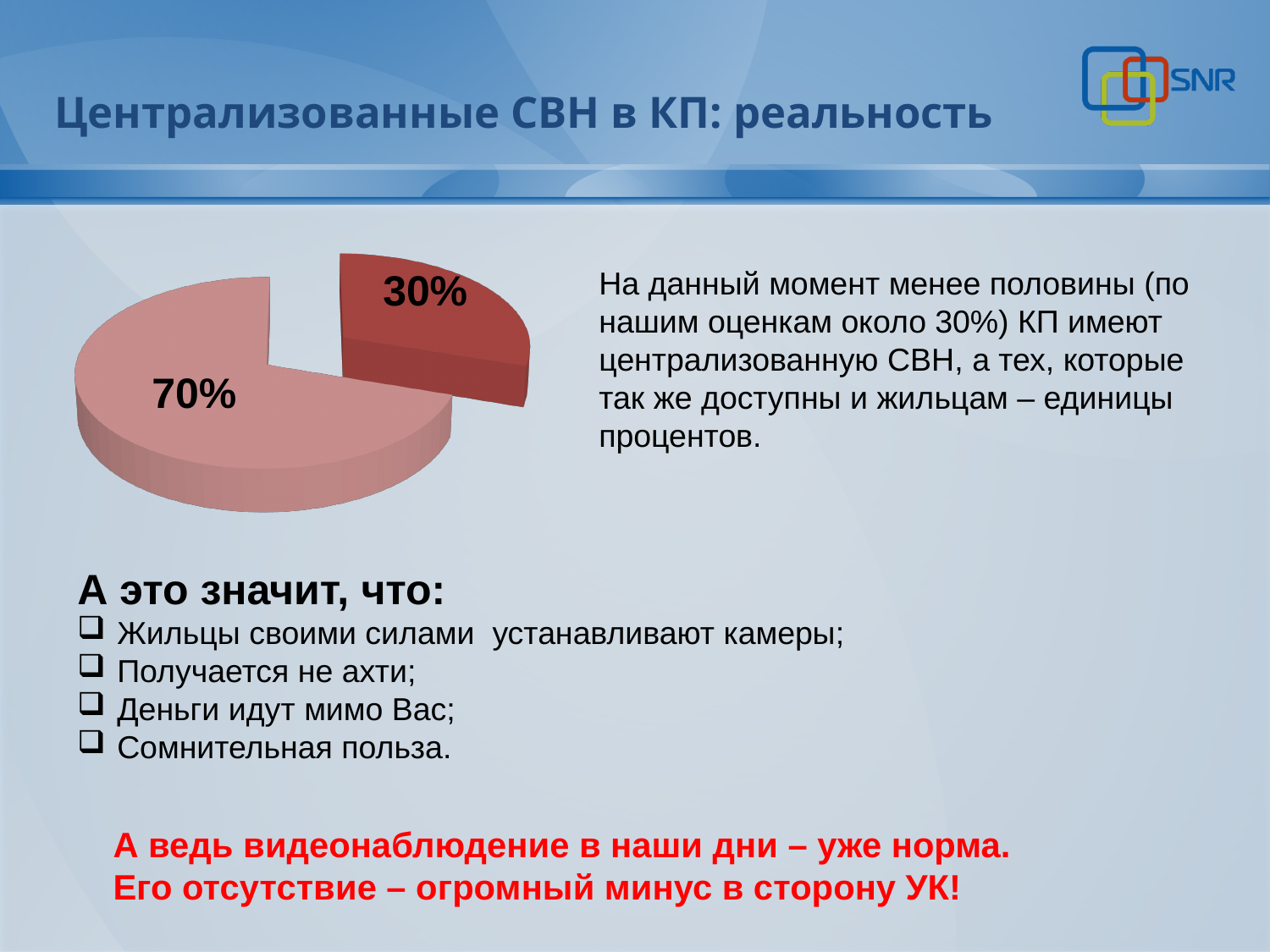
What is the value shown on the larger slice of the pie chart? 70% What is the smallest value shown on the pie chart? 30% What is the difference between the two slice values on the pie chart? 40% What share of the pie does the light pink slice represent? 70% What is the value shown on the smaller, dark red slice of the pie chart? 30% What is the largest value shown on the pie chart? 70% What colour is the slice labelled 30% on the pie chart? dark red What kind of chart is shown on the slide? pie chart Which slice of the pie chart is larger, the light pink one or the dark red one? the light pink one Which slice of the pie chart is pulled out (exploded) from the rest? the 30% slice Is the value of the dark red slice greater or less than 50%? less How many slices does the pie chart have? 2